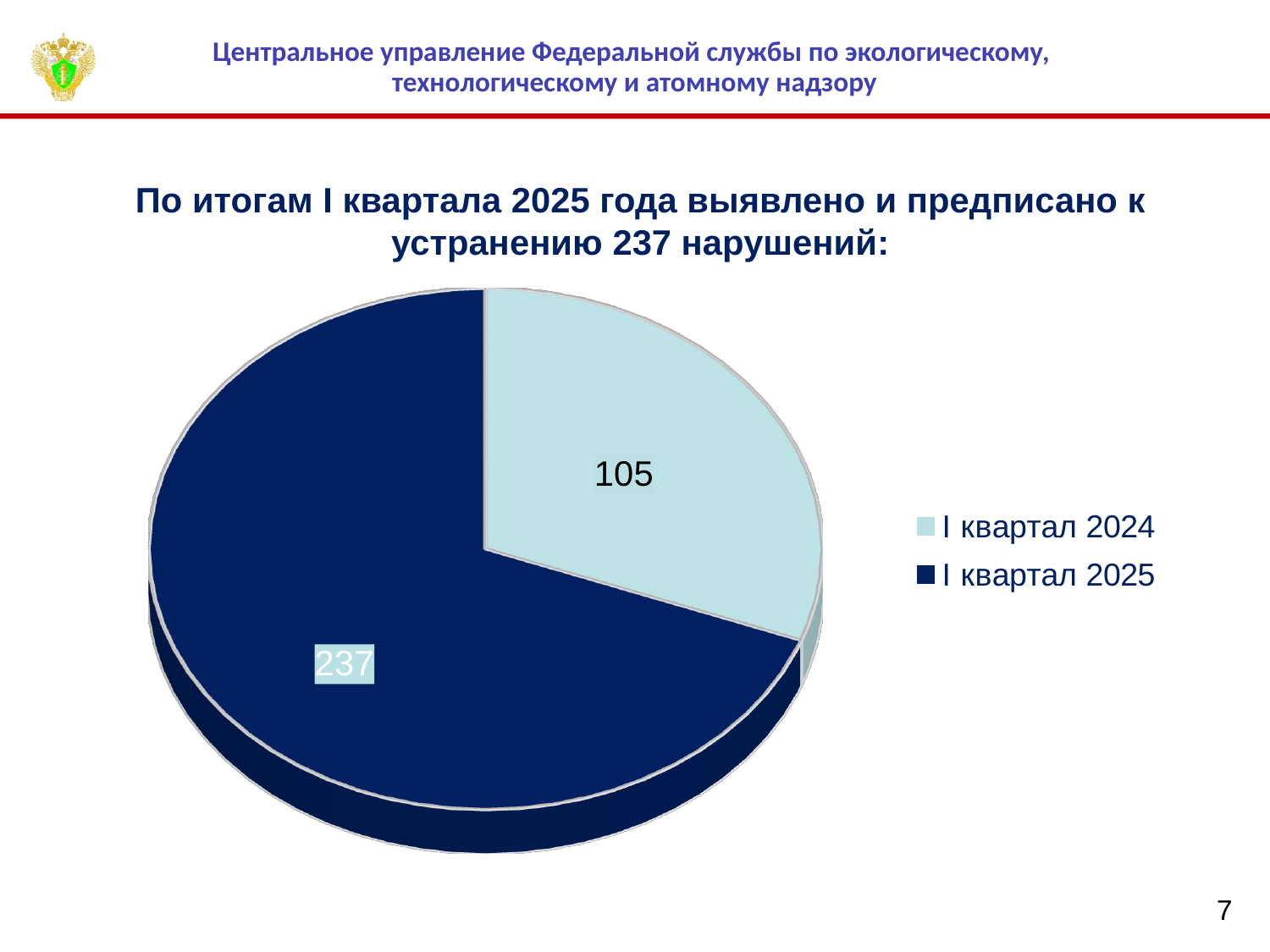
What is the total of all slices in the pie chart? 342 Which is larger, the value for I квартал 2024 or I квартал 2025? I квартал 2025 What is the difference between the values for I квартал 2025 and I квартал 2024? 132 Which slice is the smallest? I квартал 2024 How many entries does the legend list? 2 What share of the pie does the I квартал 2025 slice represent? 69.3% What is the value for I квартал 2025? 237 Which slice is the largest? I квартал 2025 What colour is the I квартал 2024 slice? Light blue What type of chart is shown on the slide? Pie chart How many slices does the pie chart have? 2 What is the value for I квартал 2024? 105